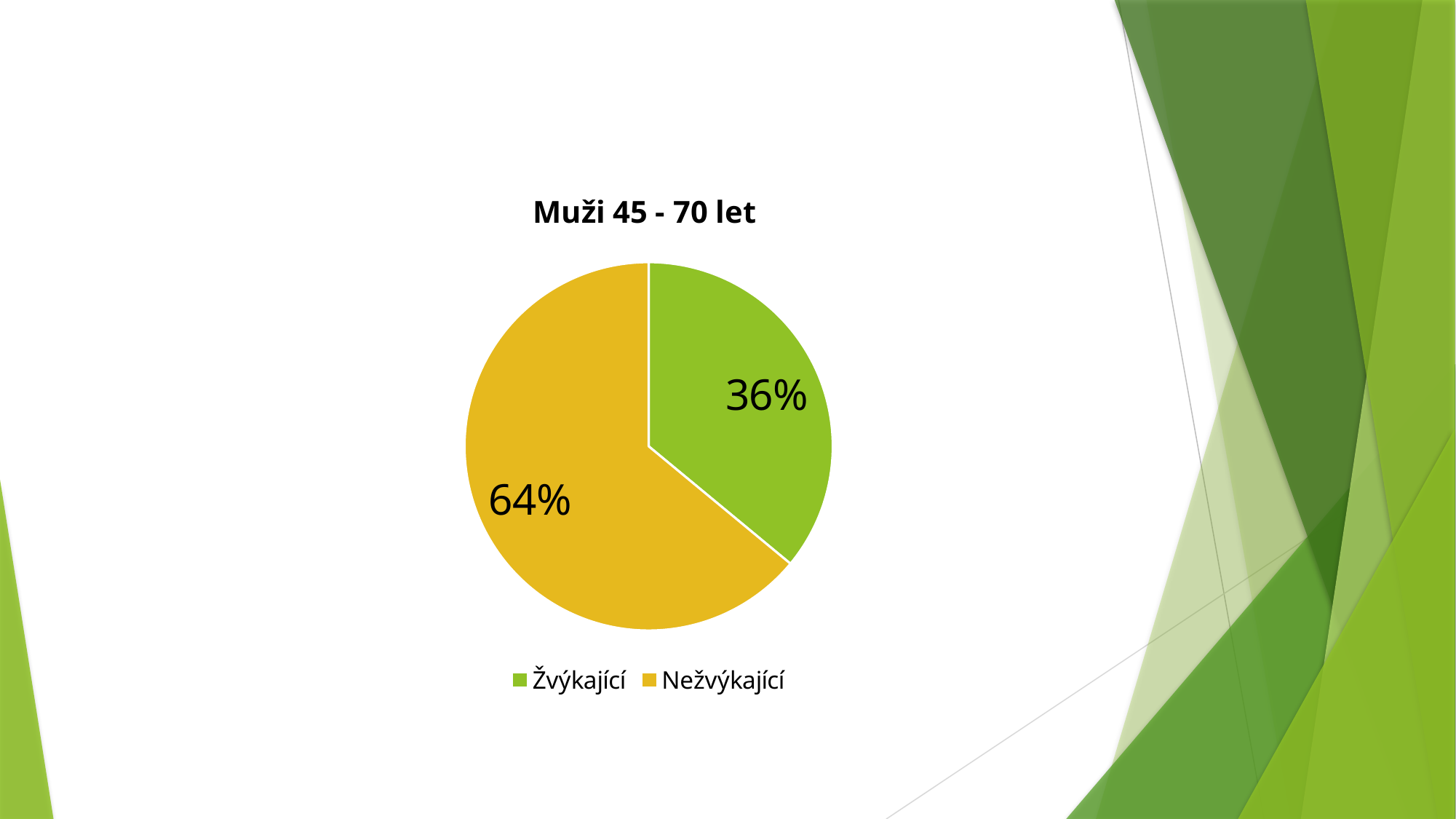
What is the title of the chart? Muži 45 - 70 let How many entries does the legend list? 2 How many slices does the pie chart have? 2 What is the difference in percentage points between Nežvýkající and Žvýkající? 28 Which is larger, the slice for Žvýkající or the slice for Nežvýkající? Nežvýkající What share of the pie does Žvýkající have? 36% Which category has the smallest slice of the pie? Žvýkající What share of the pie does Nežvýkající have? 64% What kind of chart is shown on the slide? pie chart Which category has the largest slice of the pie? Nežvýkající What colour is the slice for Nežvýkající? yellow